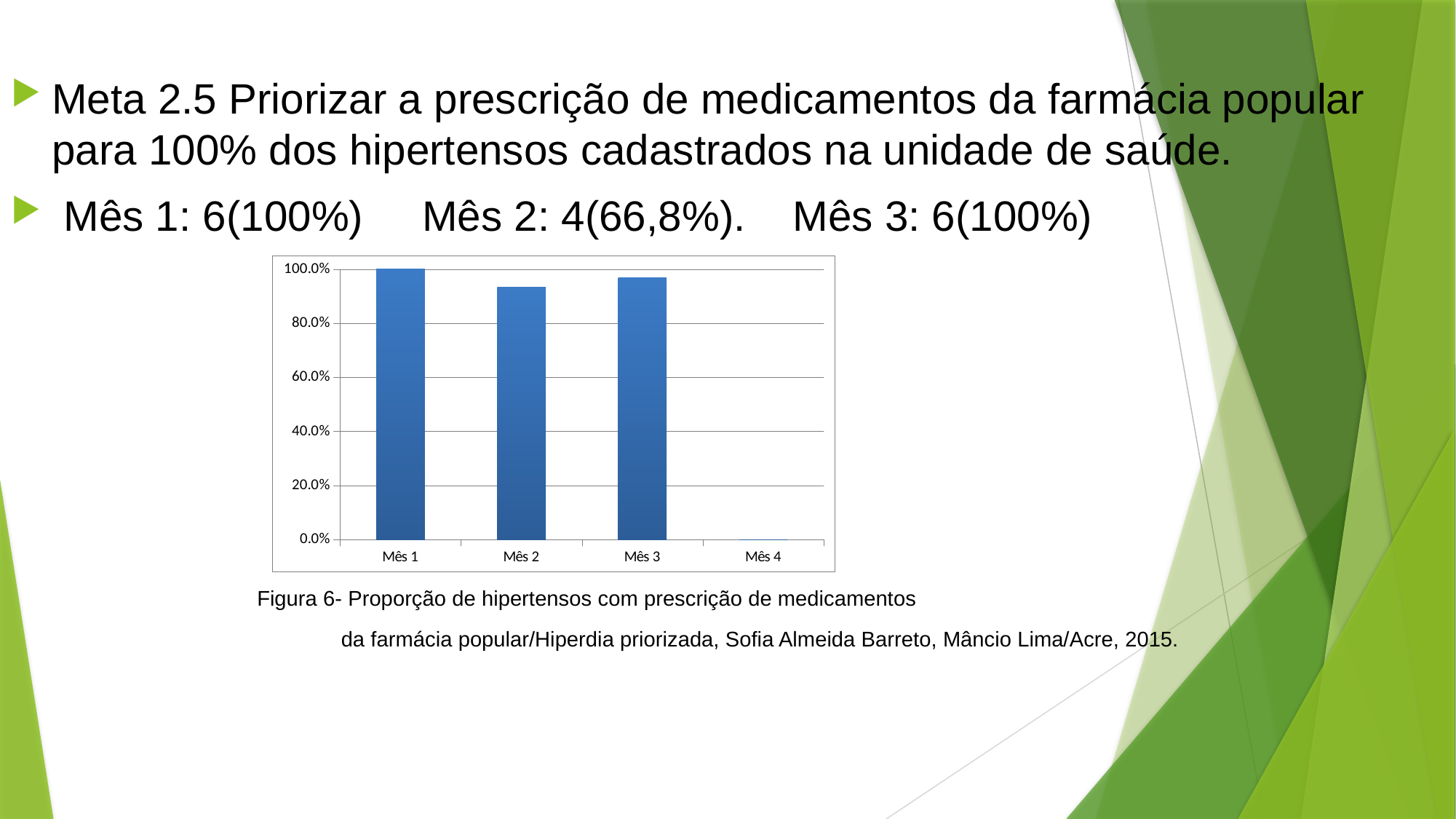
What is the highest value shown on the y axis of the chart? 100.0% How many categories are shown on the x axis of the chart? 4 Which of the three plotted bars (Mês 1, Mês 2, Mês 3) is the lowest? Mês 2 What is the value of the bar for Mês 1? 100.0% Is the value for Mês 2 greater or less than 80.0%? greater What kind of chart is shown on the slide? bar chart Which is larger, the value for Mês 2 or the value for Mês 3? Mês 3 Is the value for Mês 2 greater or less than 60.0%? greater Which category on the x axis has no bar plotted? Mês 4 Is the value for Mês 3 greater or less than 80.0%? greater Which is larger, the value for Mês 1 or the value for Mês 2? Mês 1